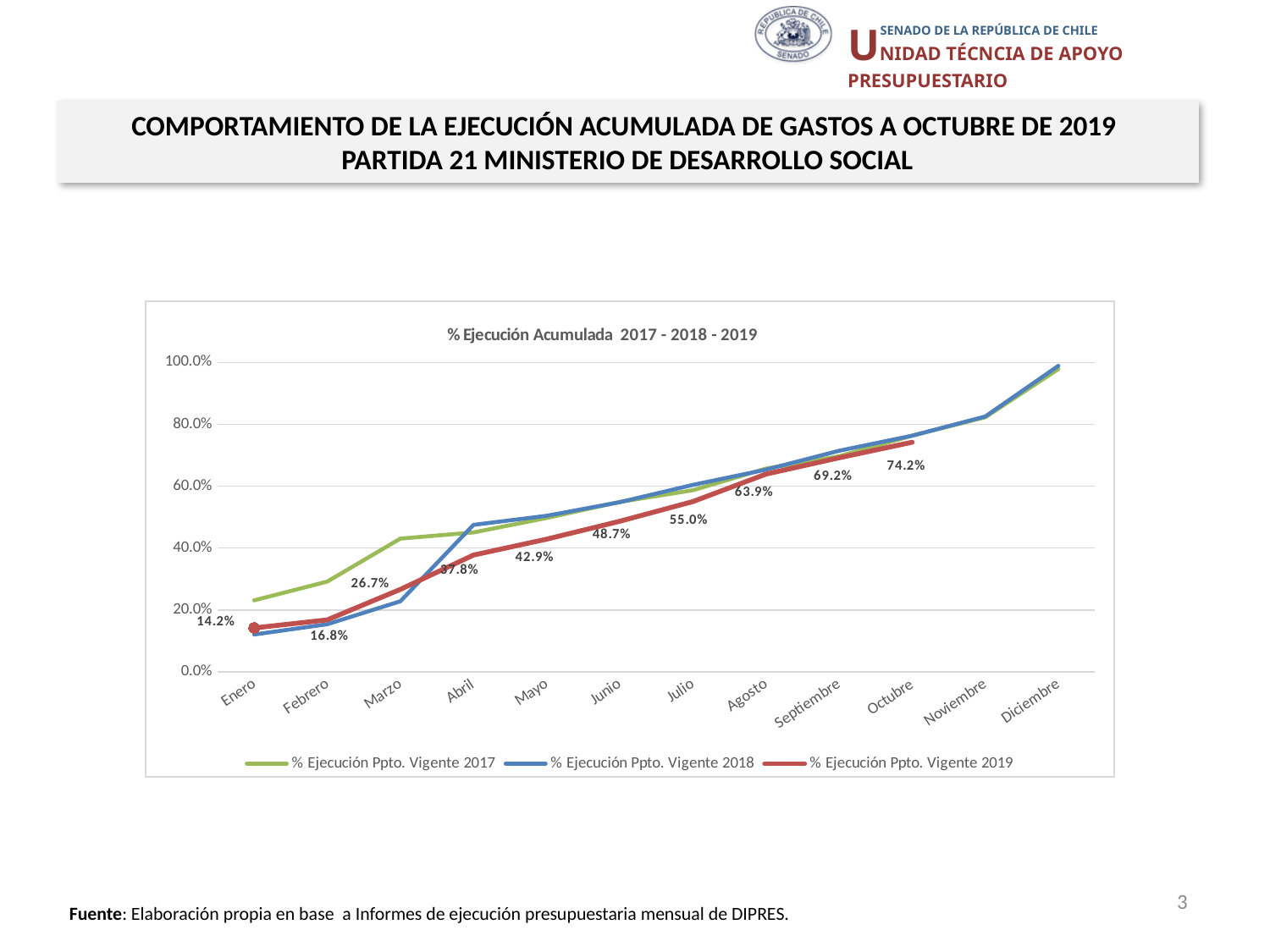
What is the difference between the 2019 values for Octubre and Septiembre? 5.0% Is the value for % Ejecución Ppto. Vigente 2018 in Diciembre greater or less than 80.0%? greater Does the % Ejecución Ppto. Vigente 2019 series rise or fall from Enero to Octubre? rise How many months are shown on the x axis? 12 What is the difference between the 2019 values for Agosto and Julio? 8.9% What is the title of the chart? % Ejecución Acumulada 2017 - 2018 - 2019 What is the value for % Ejecución Ppto. Vigente 2019 in Enero? 14.2% What is the value for % Ejecución Ppto. Vigente 2019 in Octubre? 74.2% What is the value for % Ejecución Ppto. Vigente 2019 in Julio? 55.0% How many series does the legend list? 3 What kind of chart is shown on the slide? line chart What is the value for % Ejecución Ppto. Vigente 2019 in Abril? 37.8%